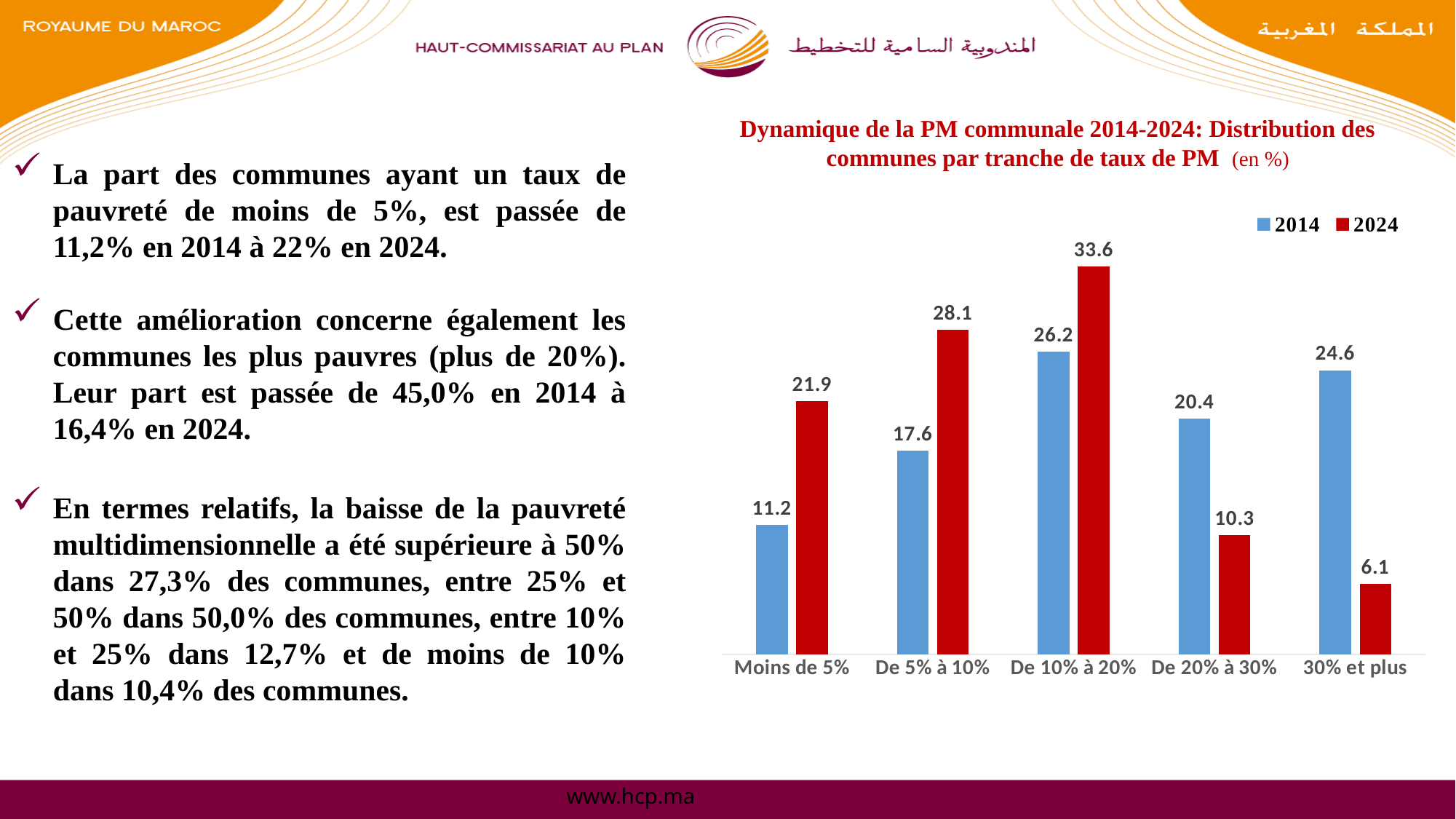
How many series does the legend list? 2 What is the value for 2024 in the 'Moins de 5%' category? 21.9 Which category has the lowest value for the 2014 series? Moins de 5% What is the value for 2024 in the '30% et plus' category? 6.1 What is the difference between the 2014 and 2024 values in the '30% et plus' category? 18.5 What is the value for 2014 in the 'De 10% à 20%' category? 26.2 How many categories are shown on the x axis? 5 What kind of chart is shown on the slide? Bar chart Which is larger in the 'De 20% à 30%' category: the 2014 value or the 2024 value? 2014 Which category has the highest value for the 2024 series? De 10% à 20% Which colour represents the 2024 series in the chart? Red What is the difference between the 2024 and 2014 values in the 'De 5% à 10%' category? 10.5